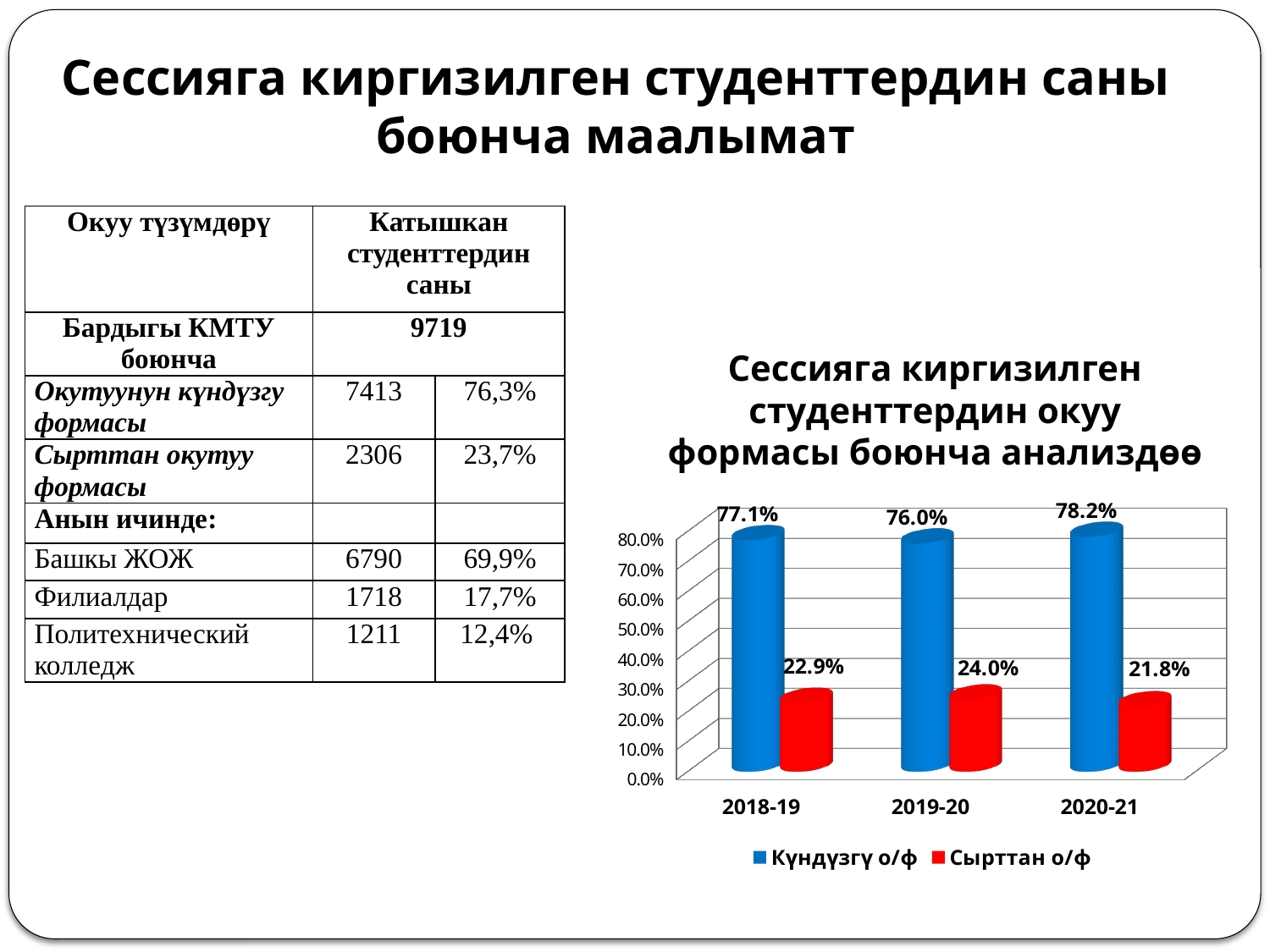
Which colour represents the Сырттан о/ф series? Red What is the value for Күндүзгү о/ф in 2020-21? 78.2% In which year is the Сырттан о/ф value lowest? 2020-21 How many series does the legend list? 2 What is the value for Сырттан о/ф in 2019-20? 24.0% In which year is the Күндүзгү о/ф value highest? 2020-21 What is the difference between the Күндүзгү о/ф values for 2020-21 and 2019-20? 2.2% What kind of chart is shown on the slide? Bar chart What is the value for Сырттан о/ф in 2020-21? 21.8% What is the value for Күндүзгү о/ф in 2018-19? 77.1% How many year categories are shown on the x axis? 3 Which is larger: the Сырттан о/ф value for 2018-19 or for 2019-20? 2019-20